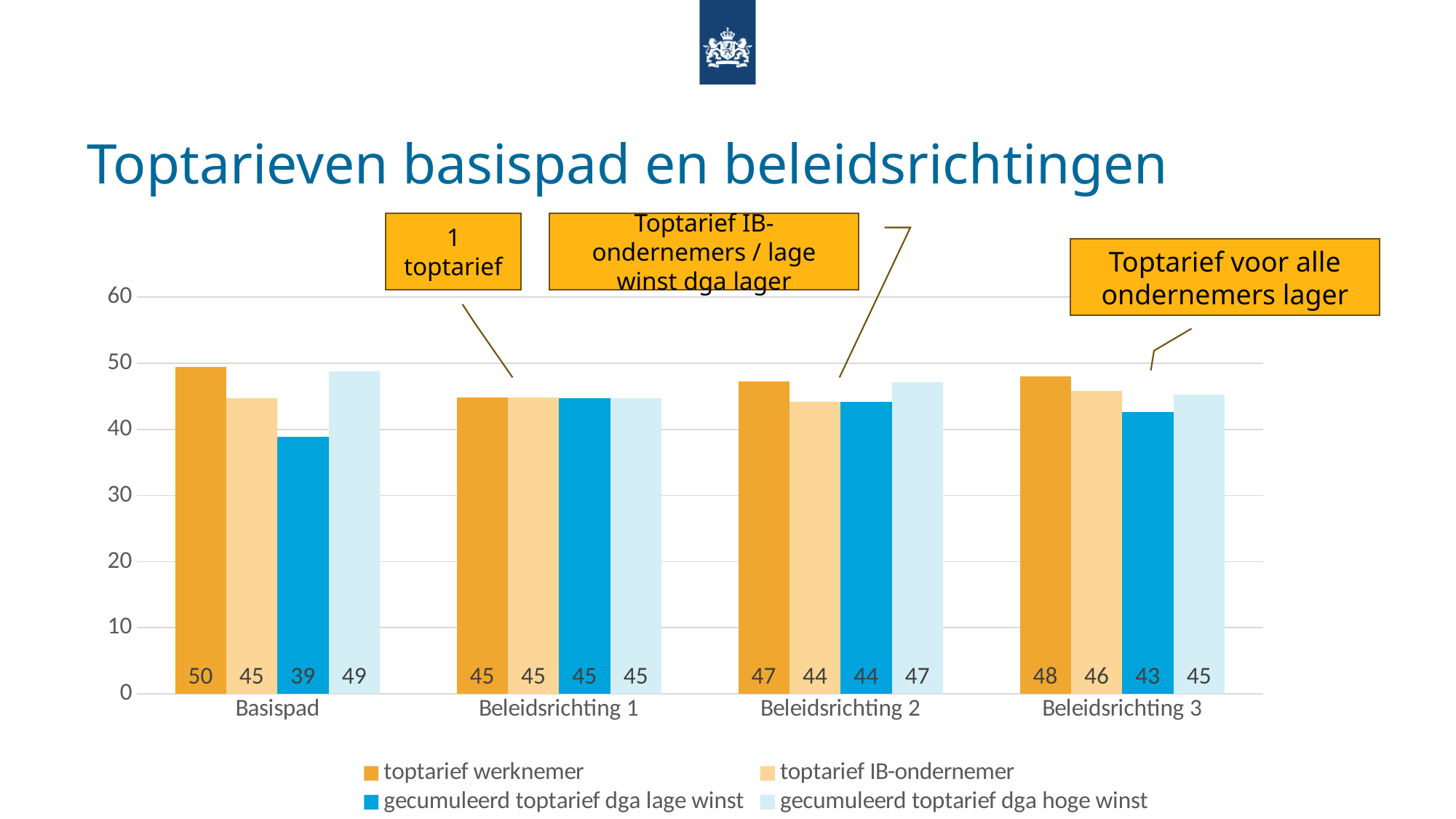
What is the value of 'toptarief IB-ondernemer' for Beleidsrichting 2? 44 Which category has the lowest value for 'gecumuleerd toptarief dga lage winst'? Basispad What is the value of 'gecumuleerd toptarief dga lage winst' for Beleidsrichting 3? 43 How many series does the legend list? 4 Which category has the highest value for 'toptarief werknemer'? Basispad What is the value of 'toptarief werknemer' for Basispad? 50 What kind of chart is shown on the slide? Bar chart What is the title of the slide? Toptarieven basispad en beleidsrichtingen What is the difference between 'toptarief werknemer' and 'gecumuleerd toptarief dga lage winst' for Basispad? 11 How many categories are shown on the x axis? 4 What does the callout above Beleidsrichting 1 say? 1 toptarief Which is larger for Beleidsrichting 3: 'toptarief IB-ondernemer' or 'gecumuleerd toptarief dga hoge winst'? toptarief IB-ondernemer